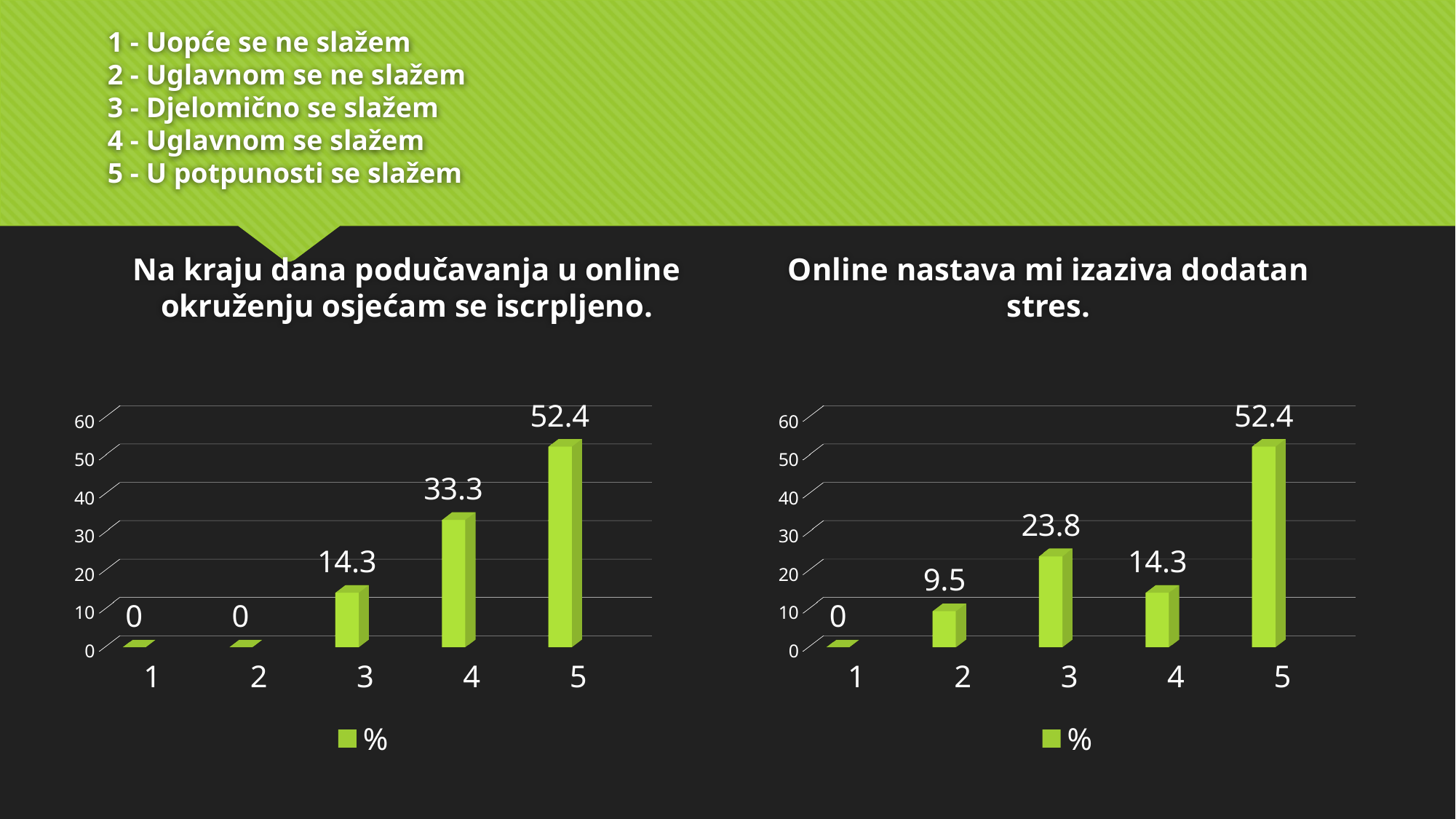
In the left chart ('Na kraju dana podučavanja u online okruženju osjećam se iscrpljeno.'), what is the value for category 3? 14.3 How many series does the legend of the right chart ('Online nastava mi izaziva dodatan stres.') list? 1 What kind of chart is the left chart ('Na kraju dana podučavanja u online okruženju osjećam se iscrpljeno.')? bar chart In the right chart ('Online nastava mi izaziva dodatan stres.'), which category has the lowest value? 1 In the right chart ('Online nastava mi izaziva dodatan stres.'), which is larger, the value for category 3 or category 4? 3 How many categories are shown on the x axis of the left chart ('Na kraju dana podučavanja u online okruženju osjećam se iscrpljeno.')? 5 In the right chart ('Online nastava mi izaziva dodatan stres.'), what is the value for category 2? 9.5 In the right chart ('Online nastava mi izaziva dodatan stres.'), is the value for category 5 greater or less than 50? greater In the left chart ('Na kraju dana podučavanja u online okruženju osjećam se iscrpljeno.'), which category has the highest value? 5 In the left chart ('Na kraju dana podučavanja u online okruženju osjećam se iscrpljeno.'), what is the value for category 4? 33.3 In the left chart ('Na kraju dana podučavanja u online okruženju osjećam se iscrpljeno.'), what is the difference between the values for category 5 and category 4? 19.1 In the right chart ('Online nastava mi izaziva dodatan stres.'), what is the value for category 3? 23.8